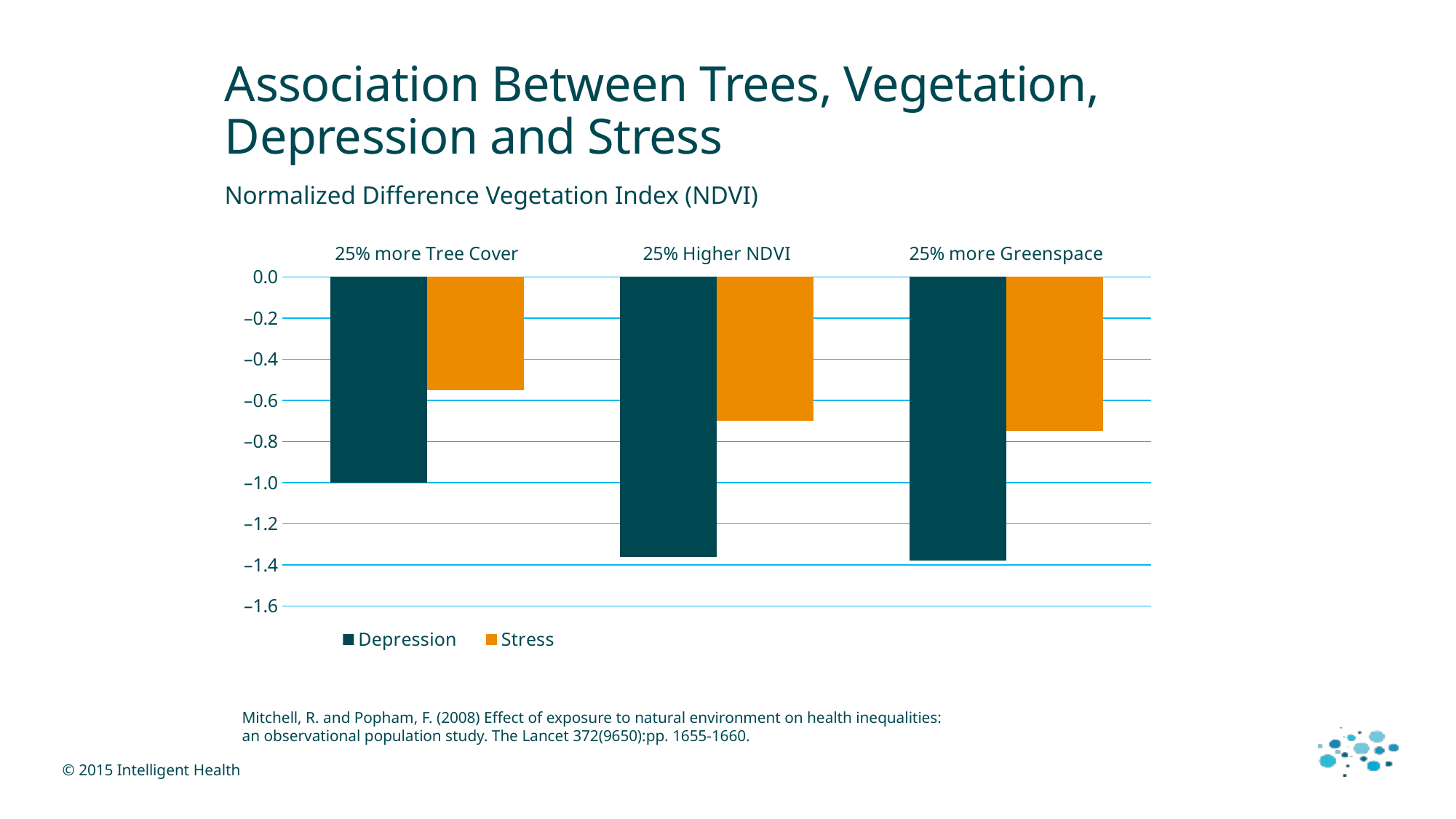
Is the Stress value for 25% more Tree Cover greater or less than –0.4? less Is the Depression value for 25% more Greenspace greater or less than –1.2? less How many series does the legend list? 2 How many categories are shown along the x axis? 3 Which bar in the chart has the highest (least negative) value? Stress for 25% more Tree Cover Within 25% more Greenspace, which series has the larger value, Depression or Stress? Stress Is the Stress value for 25% more Greenspace greater or less than –1.0? greater What is the Depression value for 25% more Tree Cover? –1.0 Which is larger, the Depression value for 25% more Tree Cover or the Depression value for 25% Higher NDVI? 25% more Tree Cover What type of chart is shown on the slide? Bar chart Which colour represents the Stress series in the legend? Orange